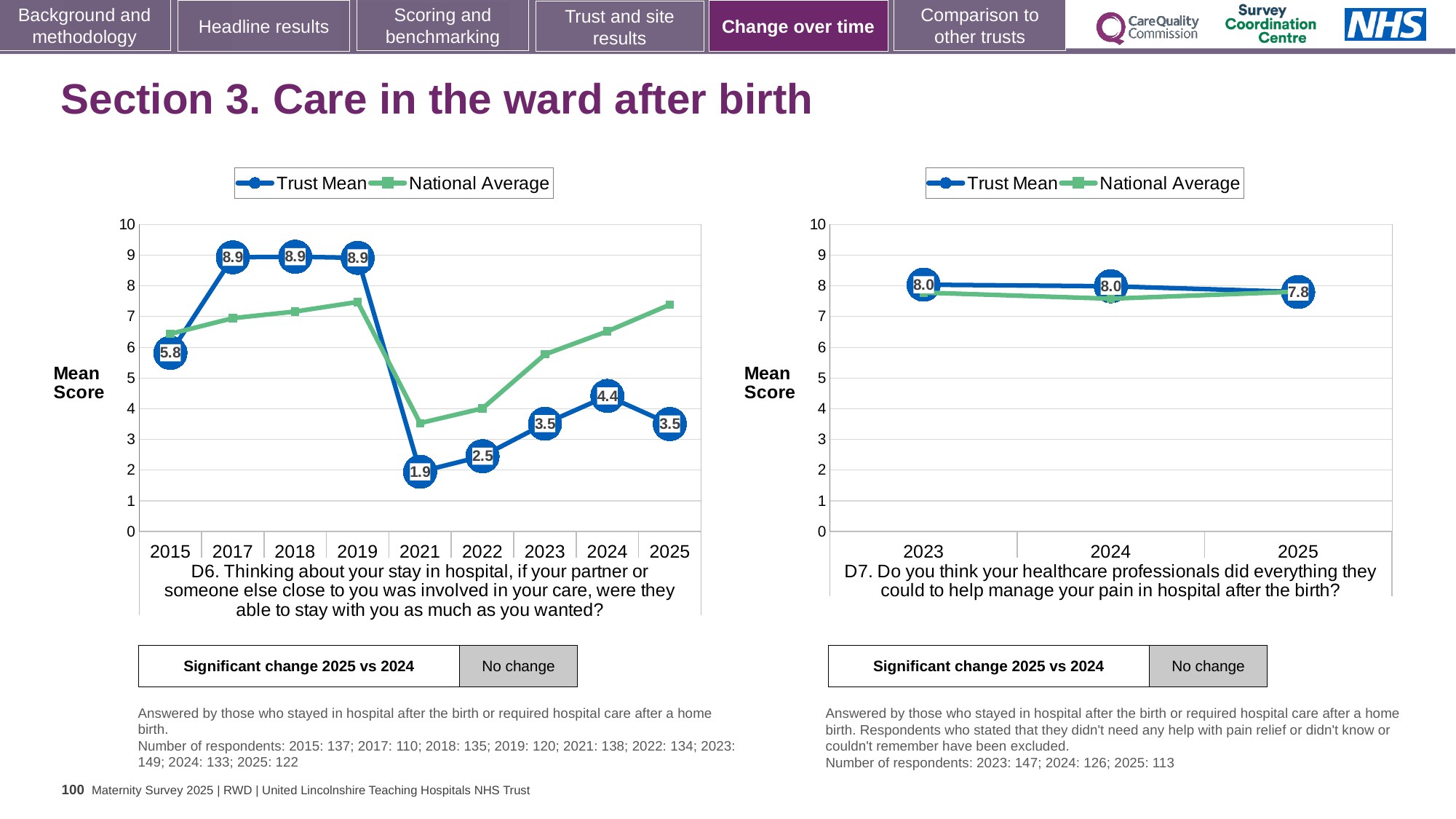
How many series does the legend of the D6 chart on the left list? 2 In the D6 chart on the left, what is the Trust Mean score for 2021? 1.9 In the D6 chart on the left, what is the difference between the Trust Mean scores for 2024 and 2025? 0.9 In the D6 chart on the left, which is larger: the Trust Mean score for 2015 or for 2022? 2015 In the D6 chart on the left, how many years are plotted on the x axis? 9 In the D7 chart on the right, does the Trust Mean rise or fall from 2023 to 2025? fall In the D7 chart on the right, what is the Trust Mean score for 2025? 7.8 What kind of chart is the D7 chart on the right? line chart In the D6 chart on the left, what is the Trust Mean score for 2015? 5.8 In the D6 chart on the left, which year has the lowest Trust Mean score? 2021 In the D6 chart on the left, is the National Average value for 2021 greater or less than 4? less In the D7 chart on the right, how many years are plotted on the x axis? 3